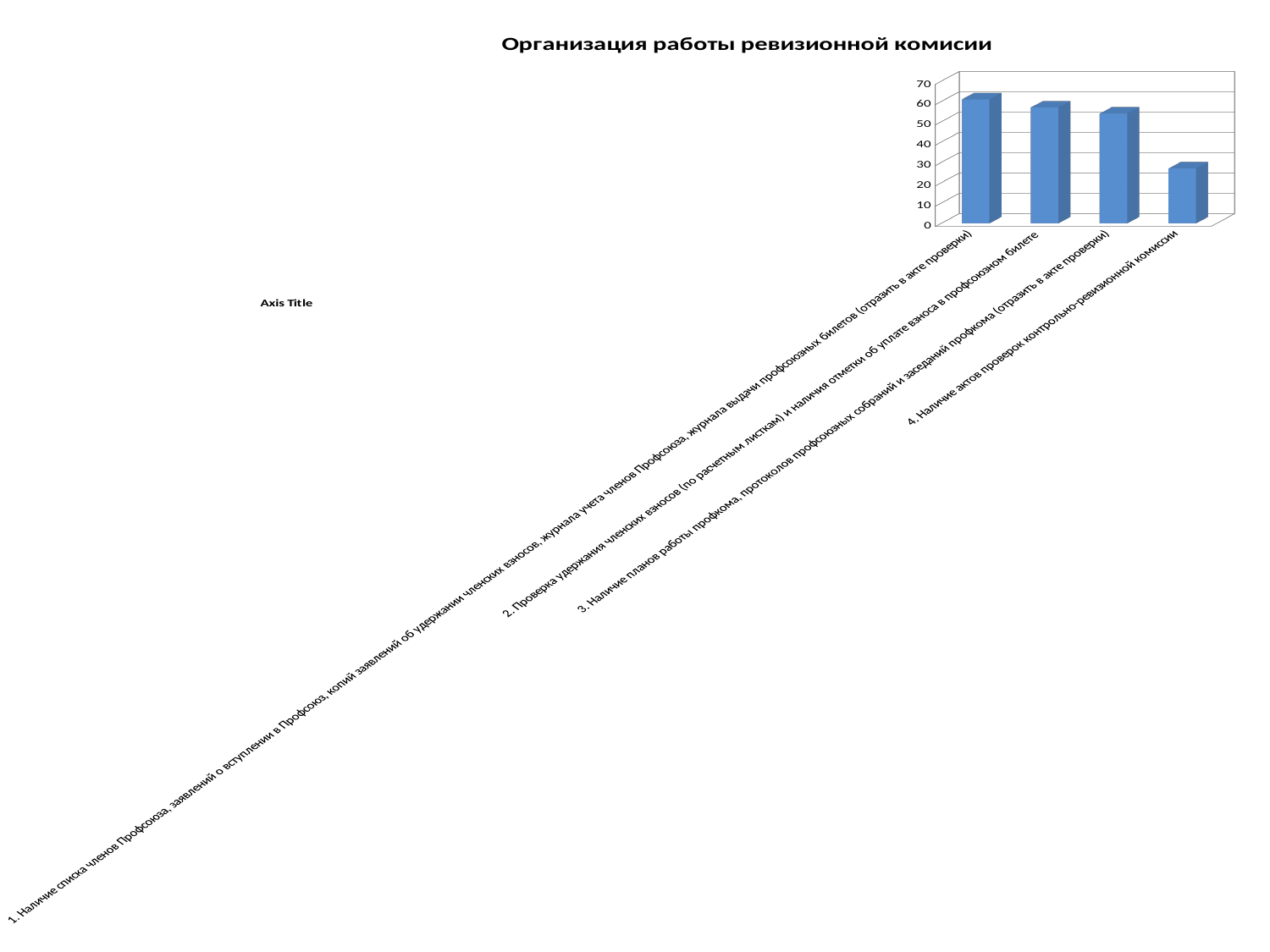
Is the value for category 3 (Наличие планов работы профкома...) greater or less than 60? less What kind of chart is shown on the slide? bar chart Is the value for category 4 (Наличие актов проверок контрольно-ревизионной комиссии) greater or less than 20? greater Which is larger: the value for category 1 (Наличие списка членов Профсоюза...) or category 4 (Наличие актов проверок контрольно-ревизионной комиссии)? category 1 (Наличие списка членов Профсоюза...) Do the bar values rise or fall from category 1 to category 4 along the x axis? fall Is the value for category 2 (Проверка удержания членских взносов...) greater or less than 50? greater What is the title of the chart? Организация работы ревизионной комисии How many categories (bars) does the chart show? 4 Which category has the lowest bar? 4. Наличие актов проверок контрольно-ревизионной комиссии